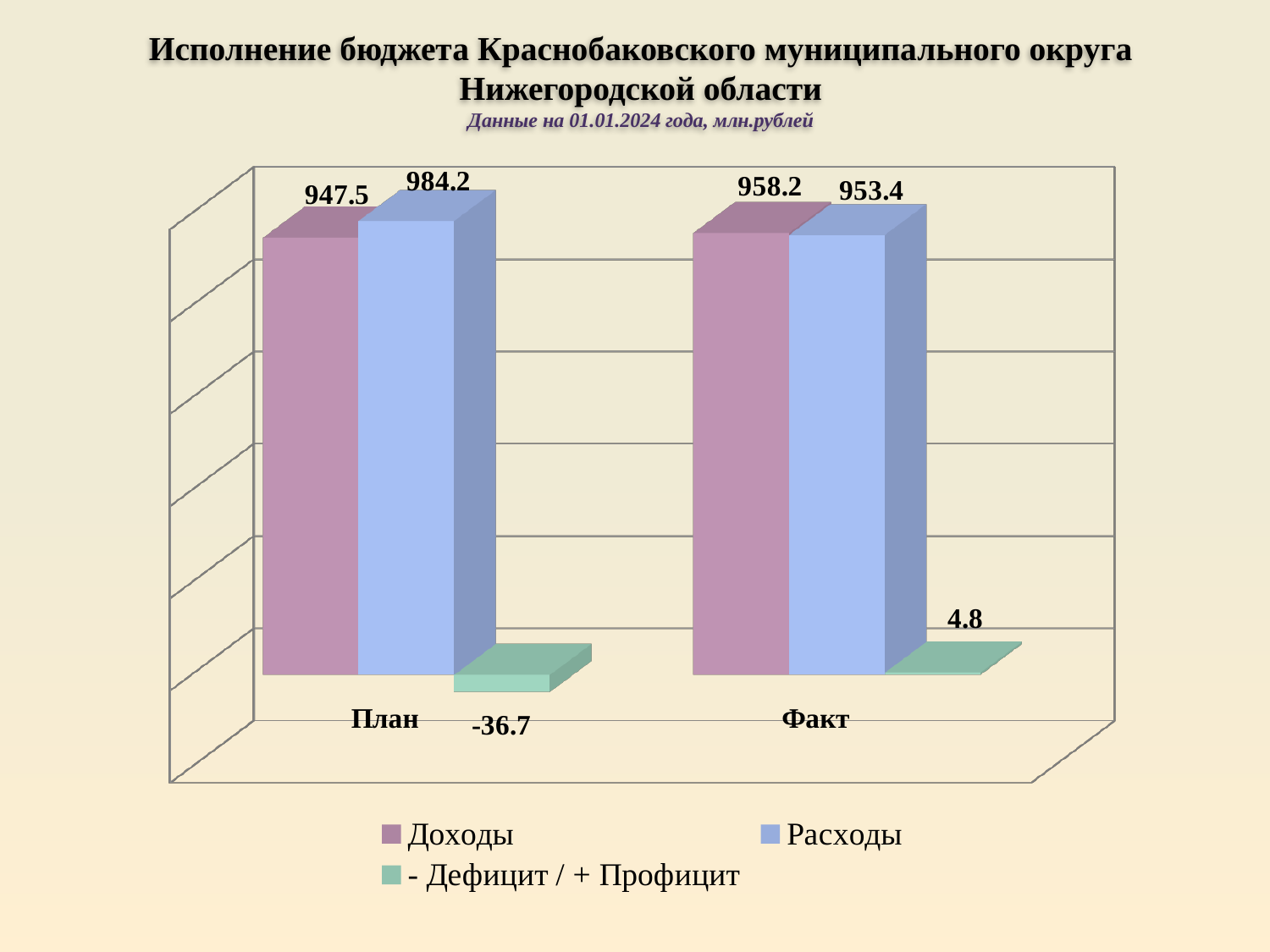
Which is larger for Факт: Доходы or Расходы? Доходы What is the value of - Дефицит / + Профицит for План? -36.7 What is the difference between Доходы for Факт and Доходы for План? 10.7 What is the value of Расходы for План? 984.2 What is the value of Расходы for Факт? 953.4 What is the difference between Расходы and Доходы for План? 36.7 What is the value of - Дефицит / + Профицит for Факт? 4.8 How many series does the legend list? 3 How many categories are shown on the x axis? 2 What is the value of Доходы for План? 947.5 What kind of chart is shown on the slide? Bar chart What is the value of Доходы for Факт? 958.2